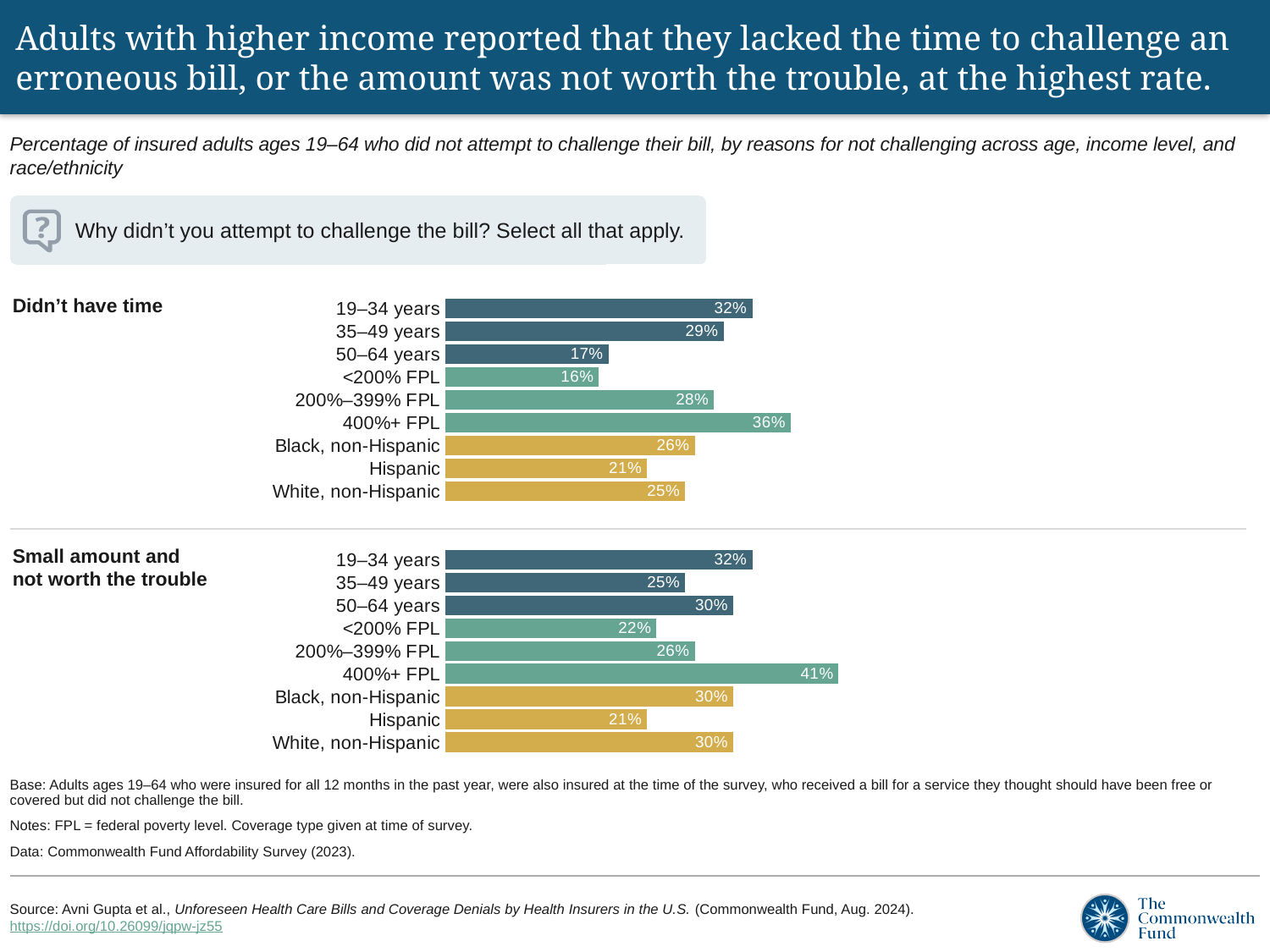
In the 'Small amount and not worth the trouble' chart, which is larger: the value for 50–64 years or the value for 35–49 years? 50–64 years In the 'Didn't have time' chart, which is larger: the value for Black, non-Hispanic or the value for Hispanic? Black, non-Hispanic In the 'Didn't have time' chart, which category has the lowest value? <200% FPL In the 'Small amount and not worth the trouble' chart, what is the value for Hispanic adults? 21% What type of chart is used on this slide? Bar chart In the 'Didn't have time' chart, what is the value for 400%+ FPL? 36% How many categories are shown in the 'Didn't have time' chart? 9 In the 'Didn't have time' chart, do the values rise or fall across the three age groups from 19–34 years to 50–64 years? Fall In the 'Small amount and not worth the trouble' chart, which category has the highest value? 400%+ FPL In the 'Didn't have time' chart, what is the difference between the values for 19–34 years and 50–64 years? 15 percentage points In the 'Small amount and not worth the trouble' chart, what is the difference between 400%+ FPL and <200% FPL? 19 percentage points In the 'Small amount and not worth the trouble' chart, what is the value for White, non-Hispanic adults? 30%